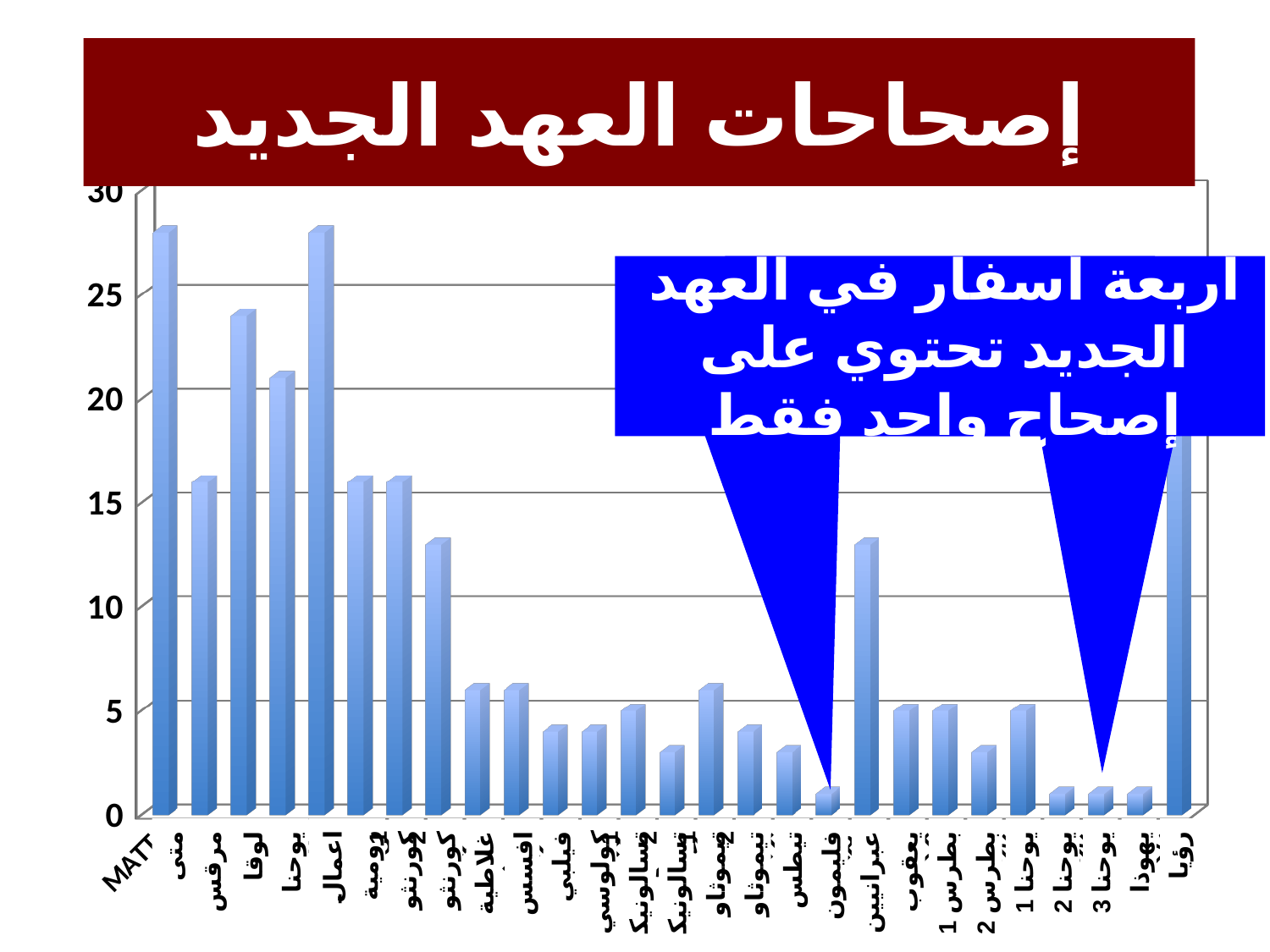
Which has the larger value, رؤيا or عبرانيين? رؤيا What is the highest value shown on the vertical axis of the chart? 30 Is the value for فليمون greater or less than 5? less Is the value for 2تسالونيك greater or less than 5? less What kind of chart is shown on the slide? bar chart Is the value for عبرانيين greater or less than 10? greater Which has the larger value, عبرانيين or يعقوب? عبرانيين Which has the larger value, لوقا or مرقس? لوقا What is the title of the chart on the slide? إصحاحات العهد الجديد